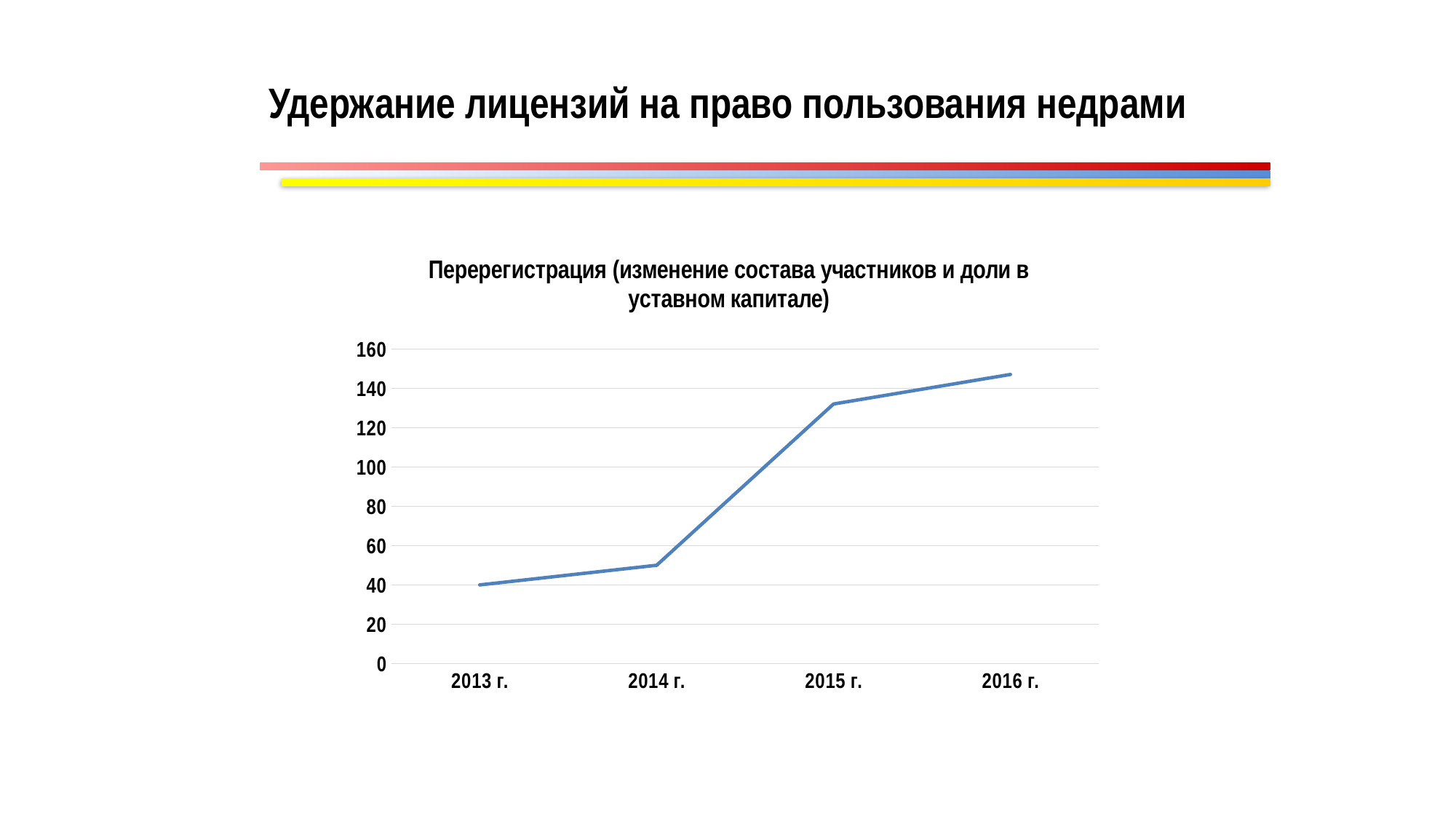
What is the value for 2013 г. in the chart? 40 Is the value for 2014 г. greater or less than 60? less Is the value for 2015 г. greater or less than 140? less Is the value for 2016 г. greater or less than 140? greater How many years are plotted on the x axis of the chart? 4 Which is larger, the value for 2014 г. or the value for 2015 г.? 2015 г. Which year has the highest value in the chart? 2016 г. Do the values rise or fall from 2013 г. to 2016 г.? rise What kind of chart is shown on the slide? line chart What is the title of the chart? Перерегистрация (изменение состава участников и доли в уставном капитале) Which year has the lowest value in the chart? 2013 г.